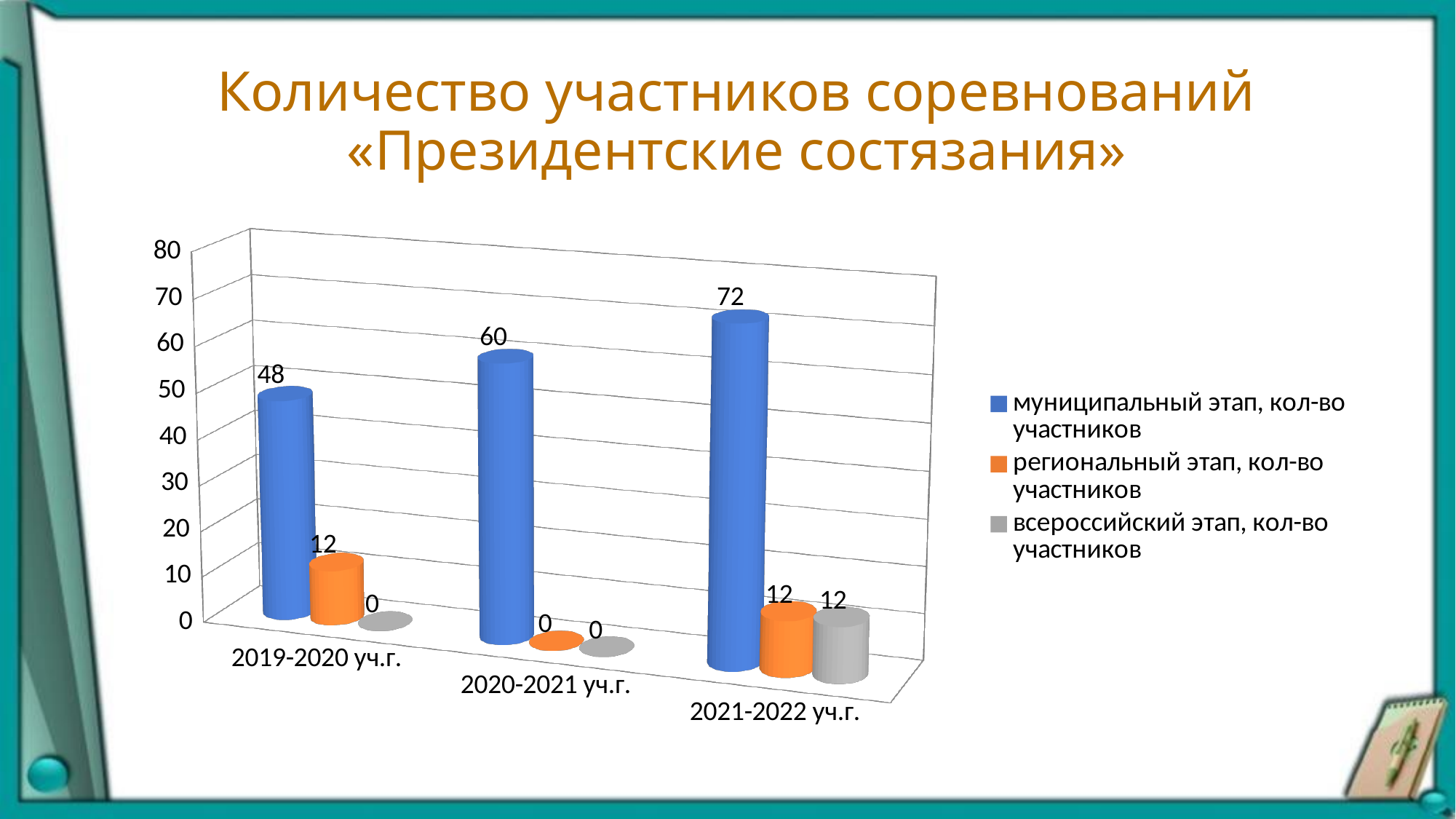
Как меняется количество участников муниципального этапа от 2019-2020 уч.г. к 2021-2022 уч.г.? Растёт Сколько учебных годов показано на оси категорий диаграммы? 3 В каком учебном году количество участников муниципального этапа было наибольшим? 2021-2022 уч.г. Сколько участников всероссийского этапа было в 2021-2022 уч.г.? 12 Сколько рядов данных перечислено в легенде диаграммы? 3 Где больше участников муниципального этапа: в 2019-2020 уч.г. или в 2020-2021 уч.г.? 2020-2021 уч.г. Сколько участников муниципального этапа было в 2019-2020 уч.г.? 48 Сколько участников регионального этапа было в 2020-2021 уч.г.? 0 В каком учебном году количество участников муниципального этапа было наименьшим? 2019-2020 уч.г. Какого типа эта диаграмма? Столбчатая (bar chart) На сколько участников муниципального этапа в 2021-2022 уч.г. больше, чем в 2019-2020 уч.г.? 24 Сколько участников муниципального этапа было в 2021-2022 уч.г.? 72